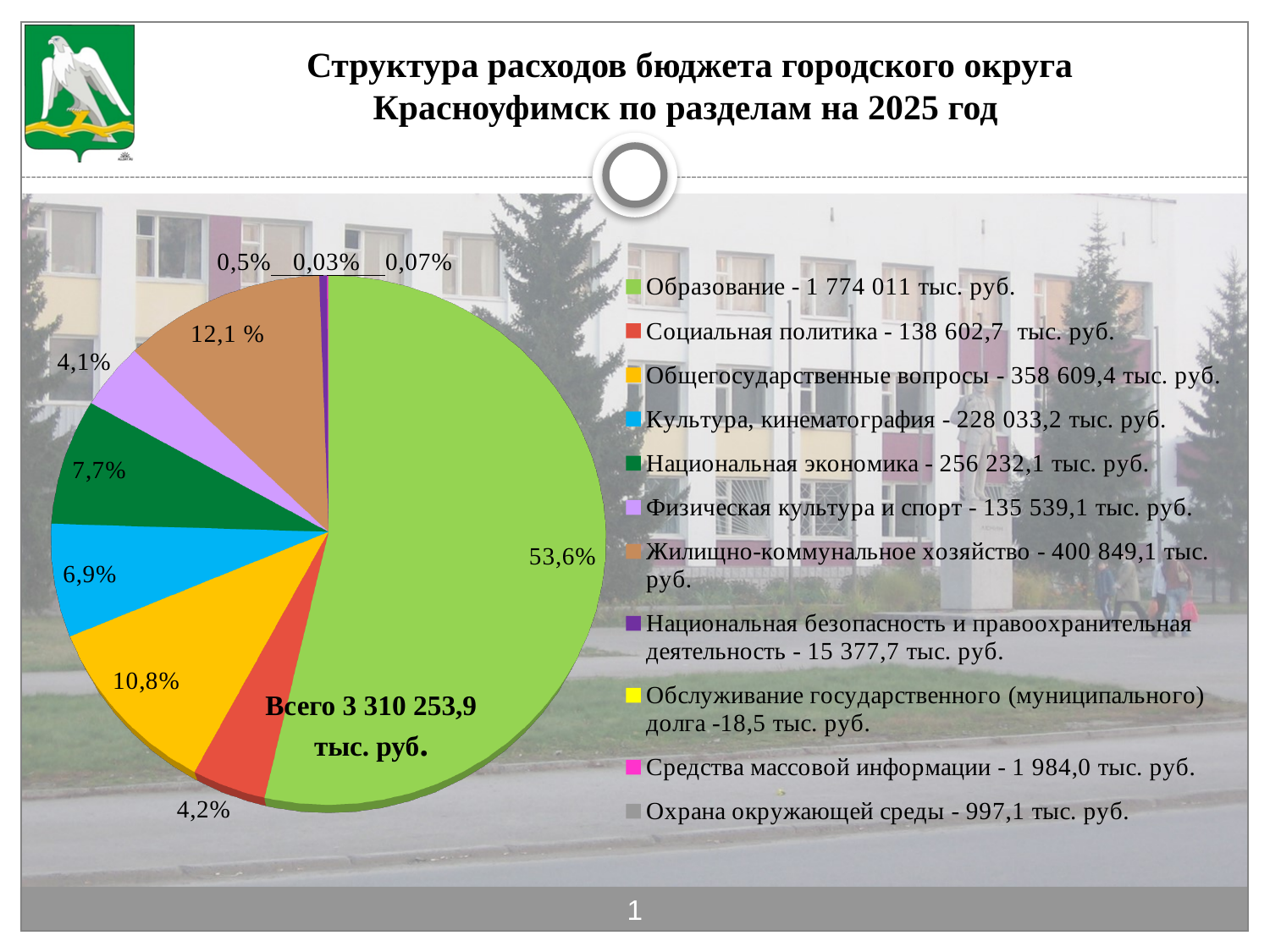
What share of the pie does Образование (the green slice) take? 53,6% What is the total amount of expenditures stated in the centre of the chart? Всего 3 310 253,9 тыс. руб. Which section has the largest share of the budget expenditures? Образование According to the legend, what is the amount for Социальная политика? 138 602,7 тыс. руб. What percentage is shown for the Национальная экономика (dark green) slice? 7,7% What percentage is shown for the Жилищно-коммунальное хозяйство (brown) slice? 12,1 % What is the difference between the amounts for Общегосударственные вопросы (358 609,4) and Культура, кинематография (228 033,2) in тыс. руб.? 130 576,2 Which is larger: the share for Культура, кинематография (6,9%) or for Физическая культура и спорт (4,1%)? Культура, кинематография What percentage is shown for the Общегосударственные вопросы (orange-yellow) slice? 10,8% What kind of chart is shown on the slide? pie chart How many sections (legend entries) does the legend list? 11 According to the legend, what is the amount for Культура, кинематография? 228 033,2 тыс. руб.